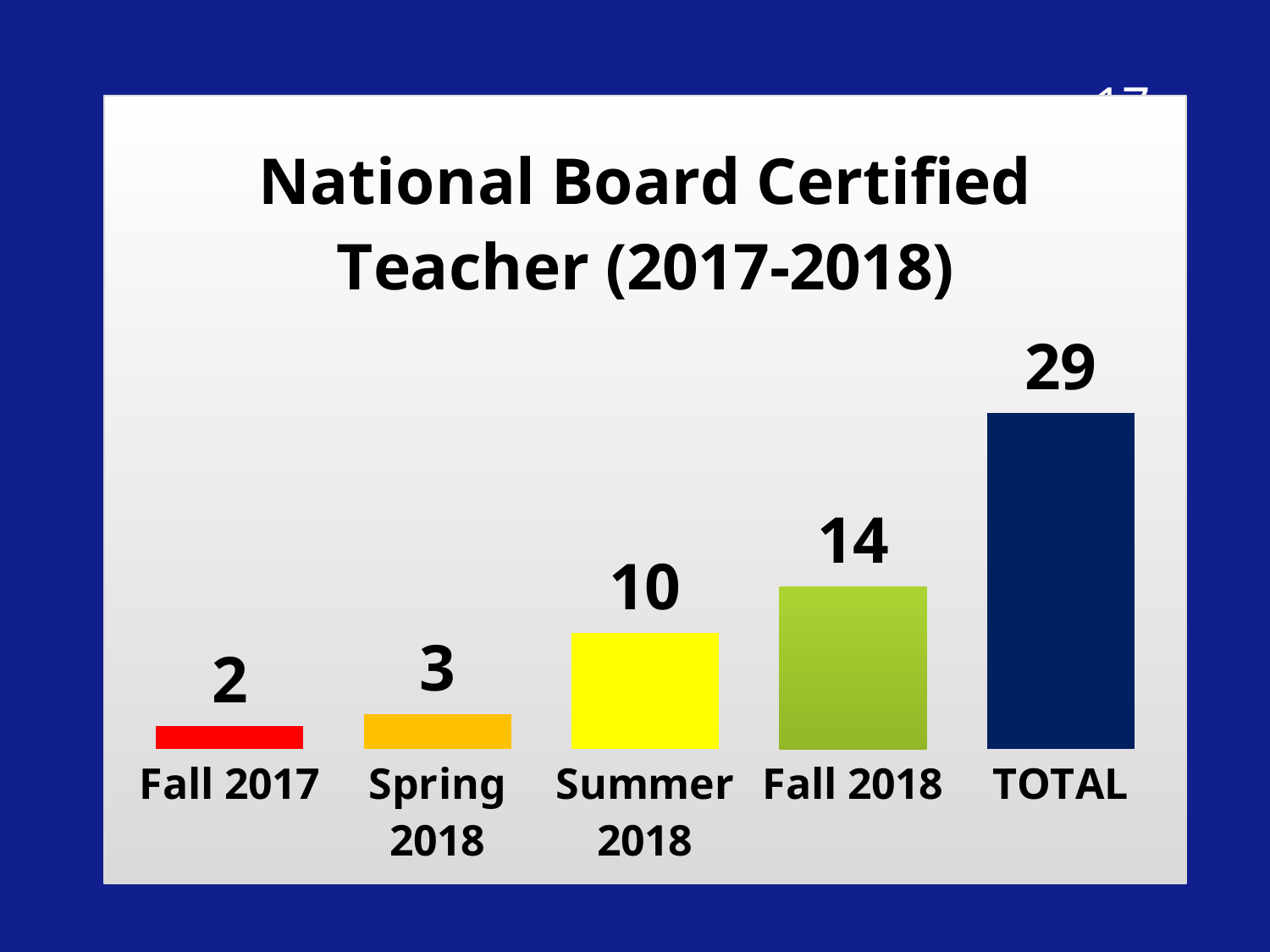
Which category has the lowest value? Fall 2017 What is the value for TOTAL? 29 Which is larger, the value for Summer 2018 or the value for Spring 2018? Summer 2018 What is the difference between the values for Fall 2018 and Summer 2018? 4 What is the value for Fall 2017? 2 What is the difference between the values for Spring 2018 and Fall 2017? 1 What is the value for Summer 2018? 10 Which category has the highest value? TOTAL What is the title of the chart? National Board Certified Teacher (2017-2018) How many categories are shown on the x axis? 5 What is the value for Fall 2018? 14 What kind of chart is shown? bar chart